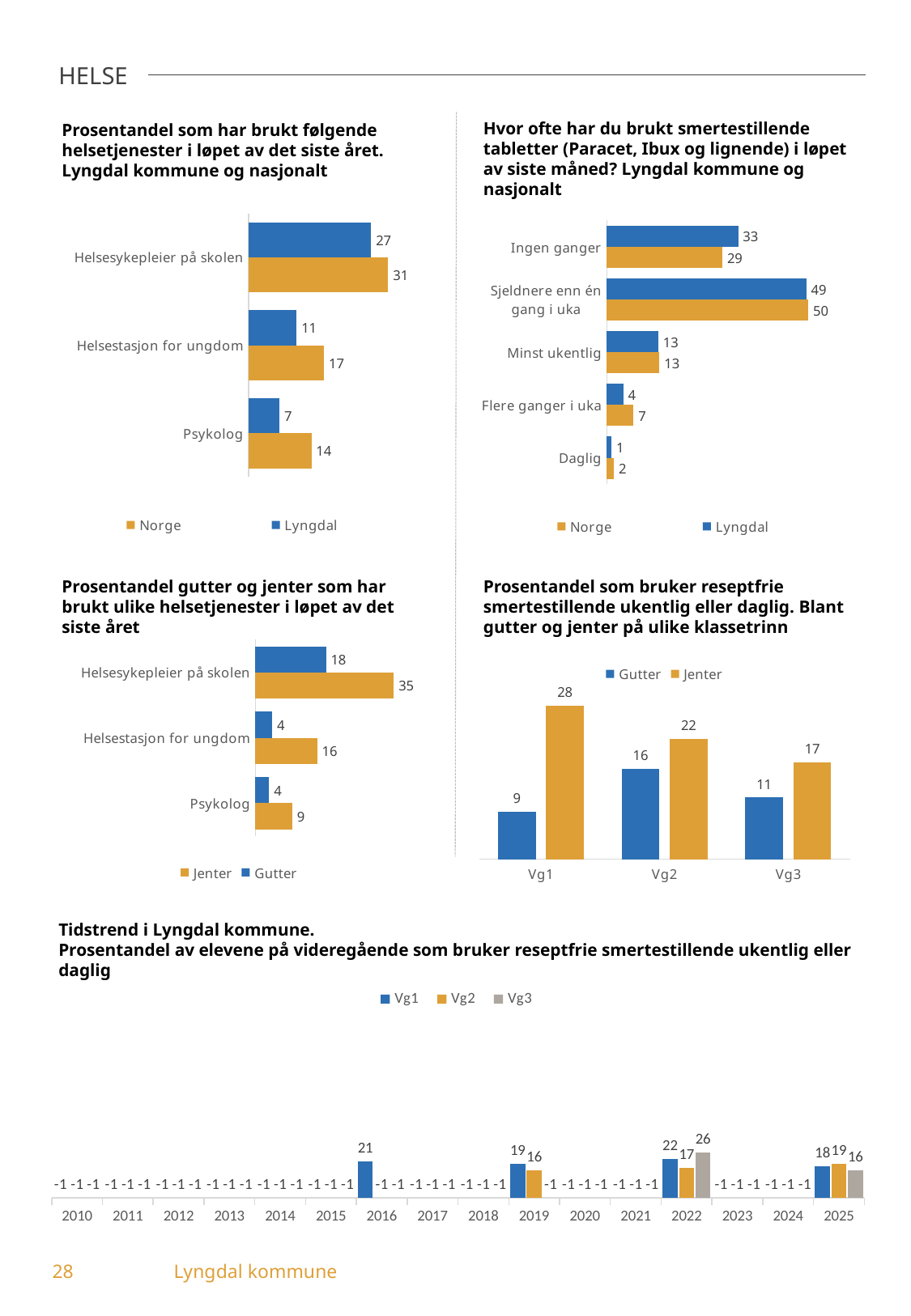
In the bottom chart (Tidstrend i Lyngdal kommune), what is the Vg3 value for 2022? 26 In the top-left chart (Prosentandel som har brukt følgende helsetjenester), what is the value for Norge for Helsesykepleier på skolen? 31 What kind of chart is the middle-right chart (Prosentandel som bruker reseptfrie smertestillende ukentlig eller daglig)? Bar chart In the top-right chart (Hvor ofte har du brukt smertestillende tabletter), what is the Norge value for Flere ganger i uka? 7 In the middle-left chart (Prosentandel gutter og jenter som har brukt ulike helsetjenester), what is the value for Jenter for Helsesykepleier på skolen? 35 In the top-right chart (Hvor ofte har du brukt smertestillende tabletter), how many categories are shown? 5 In the middle-left chart (Prosentandel gutter og jenter som har brukt ulike helsetjenester), which is larger for Helsestasjon for ungdom, Gutter or Jenter? Jenter In the top-left chart (Prosentandel som har brukt følgende helsetjenester), what is the difference between the Norge and Lyngdal values for Psykolog? 7 In the middle-right chart (Prosentandel som bruker reseptfrie smertestillende ukentlig eller daglig), what is the difference between Jenter and Gutter in Vg1? 19 In the bottom chart (Tidstrend i Lyngdal kommune), how many series does the legend list? 3 In the top-right chart (Hvor ofte har du brukt smertestillende tabletter), which category has the highest value for Lyngdal? Sjeldnere enn én gang i uka In the middle-right chart (Prosentandel som bruker reseptfrie smertestillende ukentlig eller daglig), what is the value for Gutter in Vg2? 16